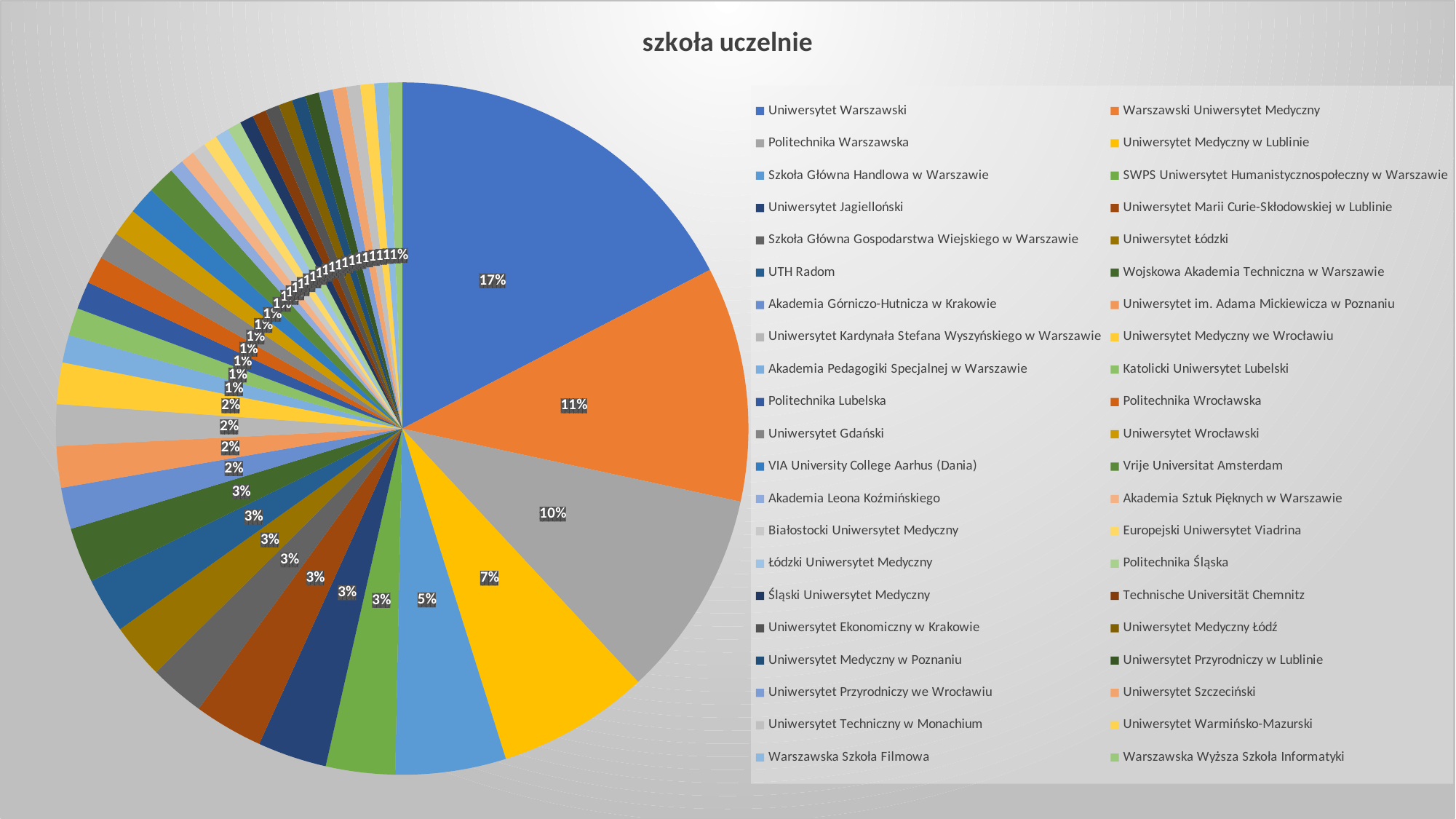
What share of the pie does Uniwersytet Warszawski have? 17% What kind of chart is shown on the slide? pie chart What share of the pie does Warszawski Uniwersytet Medyczny have? 11% What is the value shown for Szkoła Główna Handlowa w Warszawie? 5% What colour is the slice for Uniwersytet Warszawski? blue Which category has the largest slice of the pie? Uniwersytet Warszawski How many categories does the legend list? 42 What is the difference in percentage points between Uniwersytet Warszawski and Warszawski Uniwersytet Medyczny? 6 percentage points Which is larger, the slice for Politechnika Warszawska or the slice for Uniwersytet Medyczny w Lublinie? Politechnika Warszawska What is the title of the chart? szkoła uczelnie What is the value shown for Politechnika Warszawska? 10% What is the value shown for Uniwersytet Medyczny w Lublinie? 7%